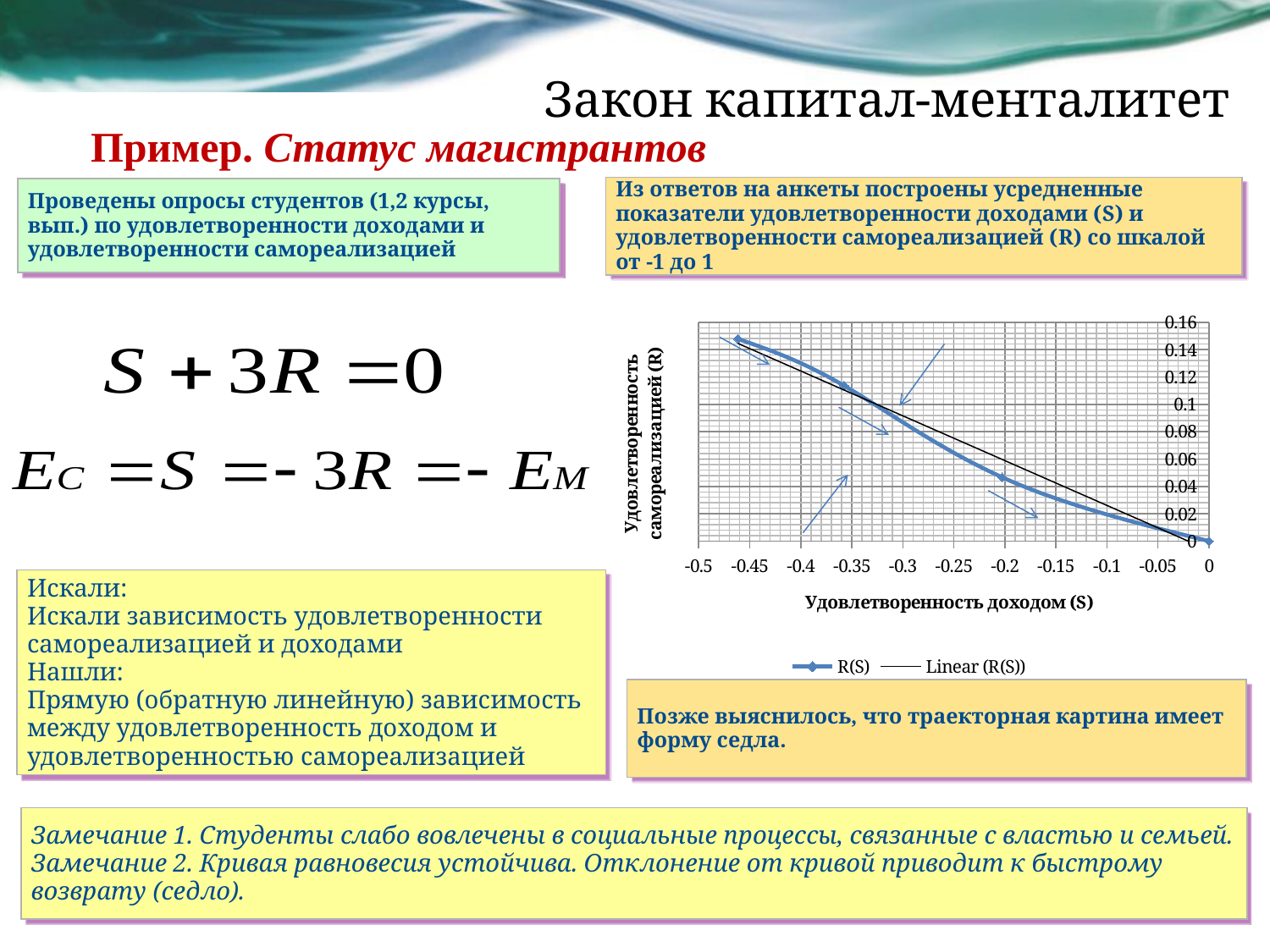
What is the title of the chart's horizontal axis? Удовлетворенность доходом (S) Is the R(S) value at S = -0.35 greater or less than 0.06? greater Is the R(S) value at S = -0.2 greater or less than 0.08? less Which has the larger R(S) value: S = -0.45 or S = -0.15? S = -0.45 Is the R(S) value at S = -0.45 greater or less than 0.1? greater How many series does the chart legend list? 2 Do the R(S) values rise or fall as S increases from -0.5 to 0 along the x axis? fall What kind of chart is shown on the slide? line chart What are the two entries in the chart legend? R(S) and Linear (R(S)) What is the highest tick value shown on the vertical axis of the chart? 0.16